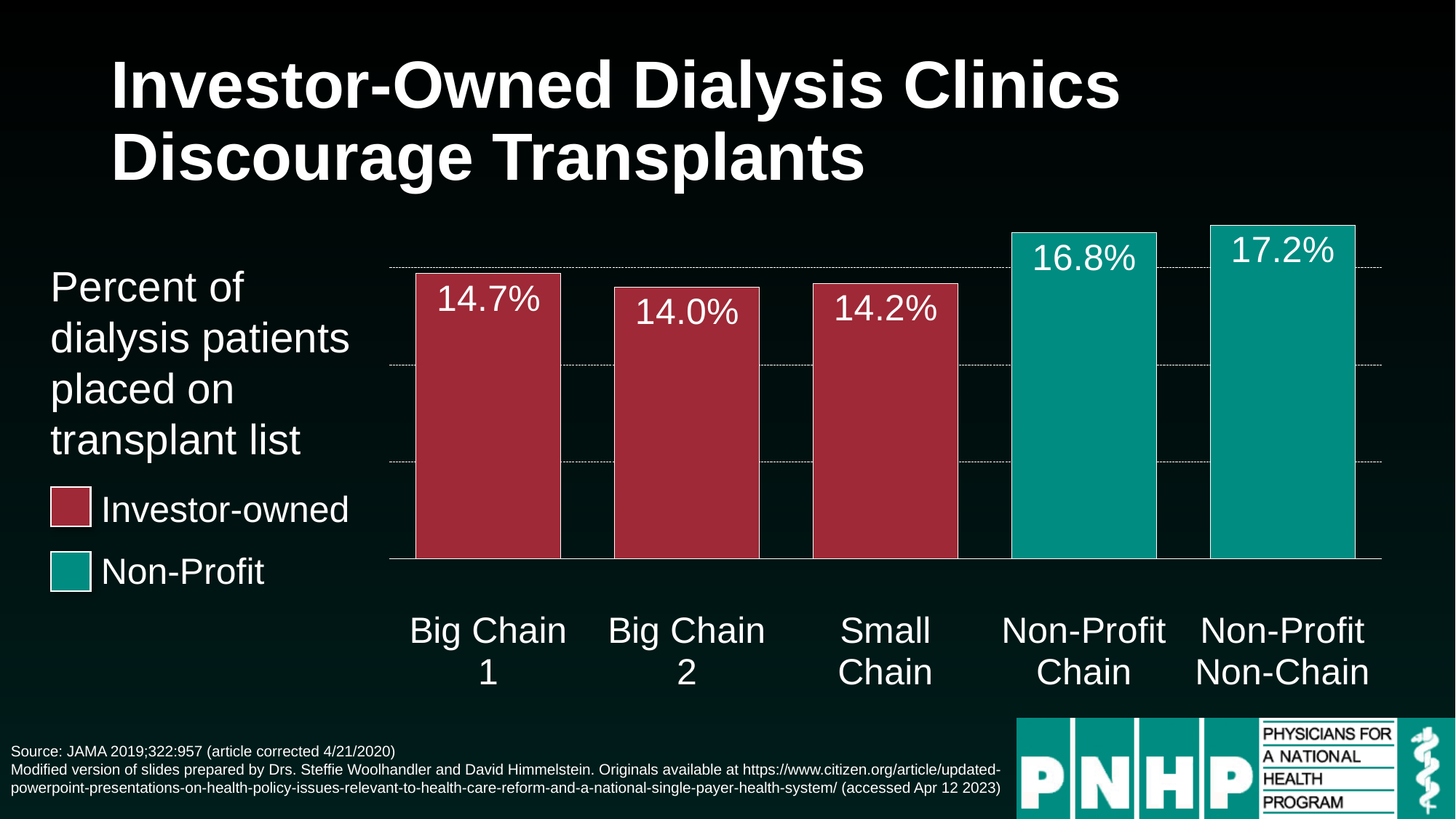
What is the value shown for Non-Profit Chain? 16.8% Which is larger, the value for Big Chain 1 or the value for Small Chain? Big Chain 1 Which category has the lowest percent of dialysis patients placed on the transplant list? Big Chain 2 What kind of chart is shown on the slide? Bar chart What is the value shown for Small Chain? 14.2% What percent of dialysis patients were placed on the transplant list for Big Chain 1? 14.7% What is the difference between the values for Non-Profit Chain and Big Chain 2? 2.8% How many series does the legend list? 2 What is the difference between the values for Non-Profit Non-Chain and Big Chain 1? 2.5% How many categories are shown on the x axis of the chart? 5 What colour are the bars for the Non-Profit series? Teal Which category has the highest percent of dialysis patients placed on the transplant list? Non-Profit Non-Chain